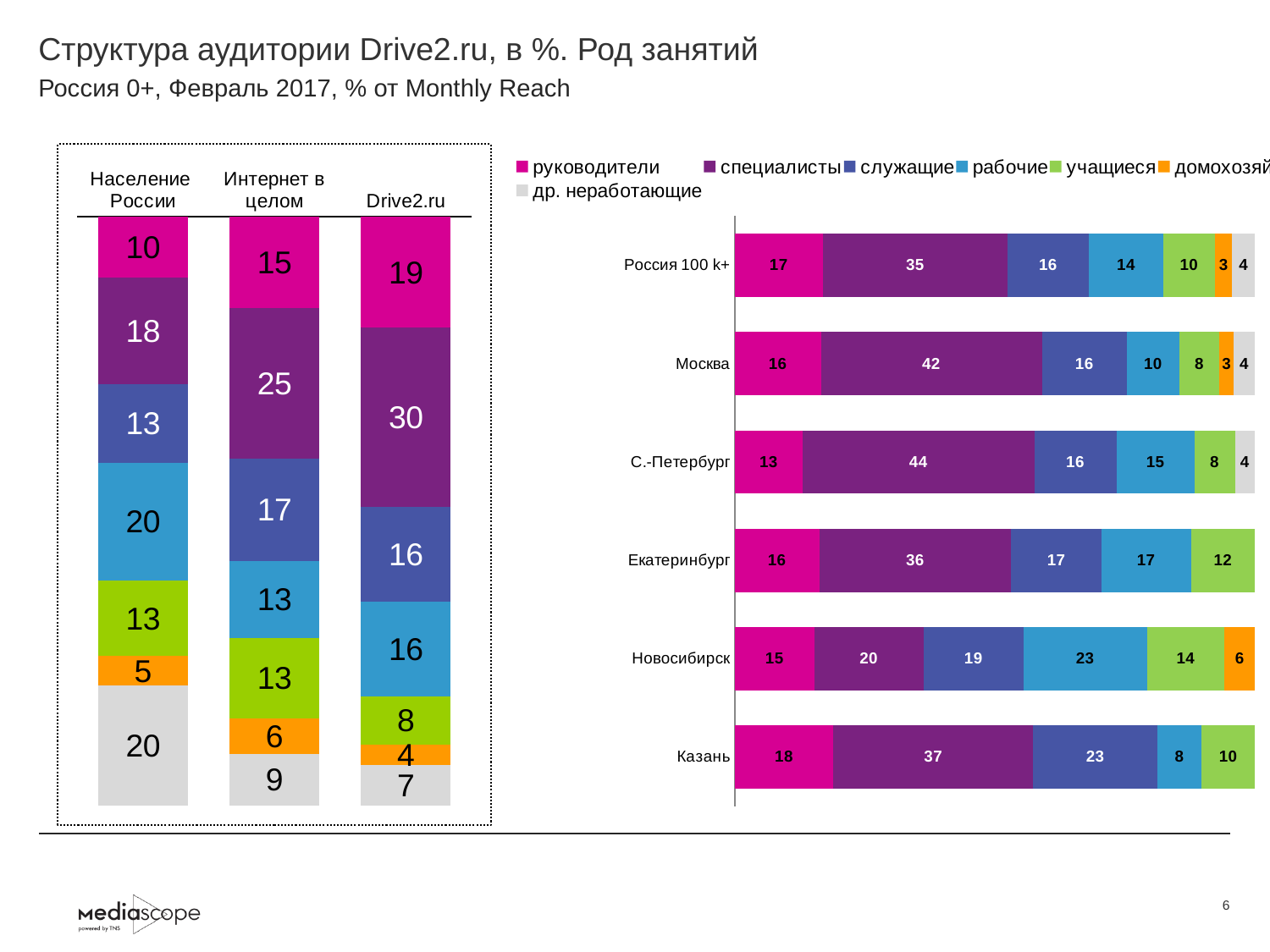
How many series does the legend of the right chart list? 7 What type of chart is the right chart? Stacked bar chart On the left chart, what is the value of the специалисты (purple) segment for Drive2.ru? 30 On the left chart, what is the value of the рабочие (light blue) segment for Население России? 20 On the right chart, which colour represents руководители? Pink On the right chart, which city has the highest value for специалисты? С.-Петербург How many cities/regions are shown on the right chart? 6 On the right chart, what is the value for рабочие in Новосибирск? 23 On the left chart, which is larger: the руководители value for Drive2.ru or for Интернет в целом? Drive2.ru On the right chart, what is the value for специалисты in Москва? 42 On the right chart, which city has the lowest value for руководители? С.-Петербург On the right chart, what is the difference between the специалисты values for Москва and Новосибирск? 22